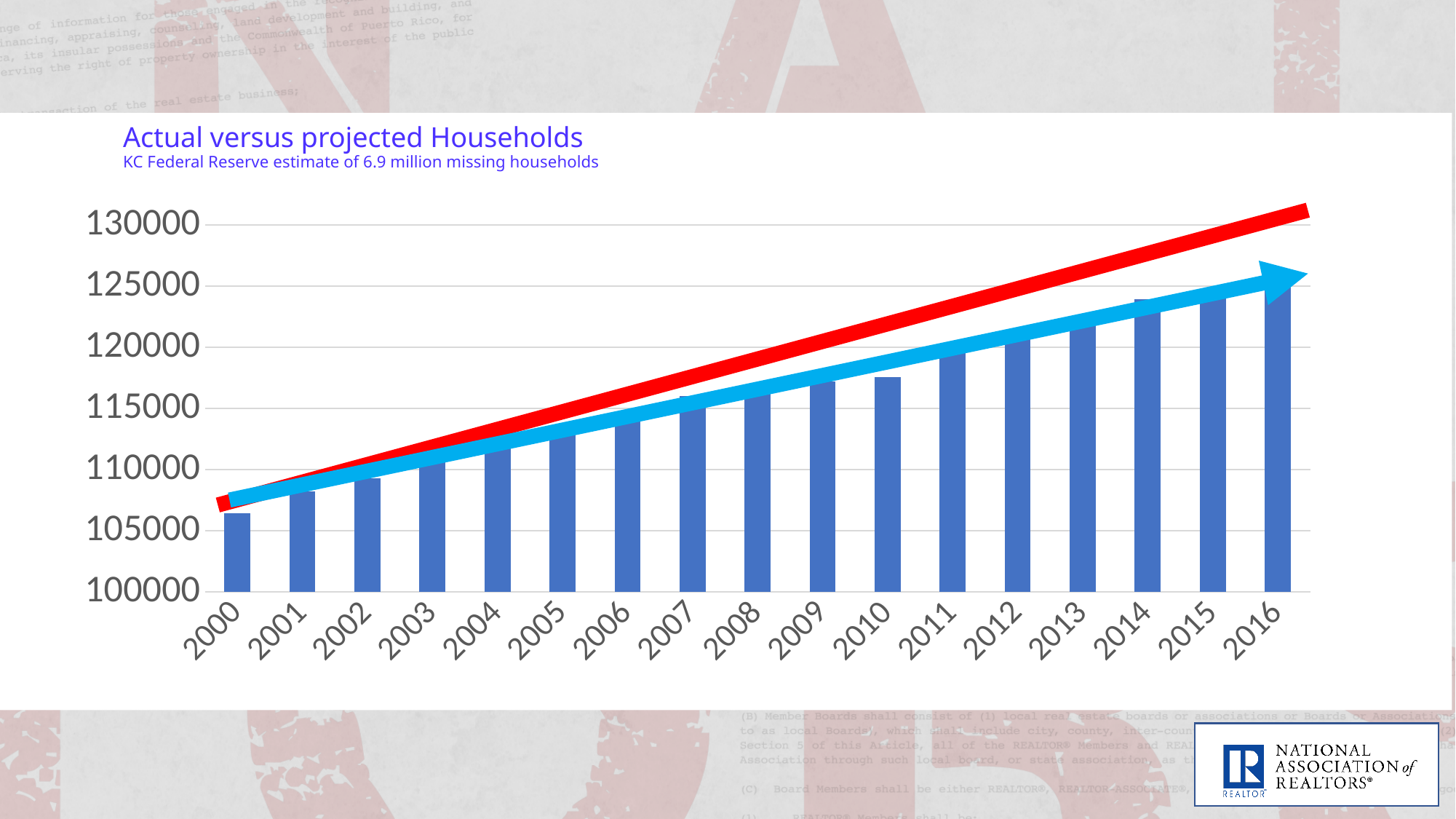
What is the title of the chart? Actual versus projected Households What kind of chart is shown on the slide? bar chart Is the value for 2000 greater or less than 110000? less Is the value for 2000 greater or less than 105000? greater Which is larger, the value for 2010 or the value for 2005? 2010 How many years are shown on the x axis of the chart? 17 Is the value for 2005 greater or less than 115000? less Which year has the tallest bar? 2016 Do the bar values rise or fall from 2000 to 2016? rise Which year has the shortest bar? 2000